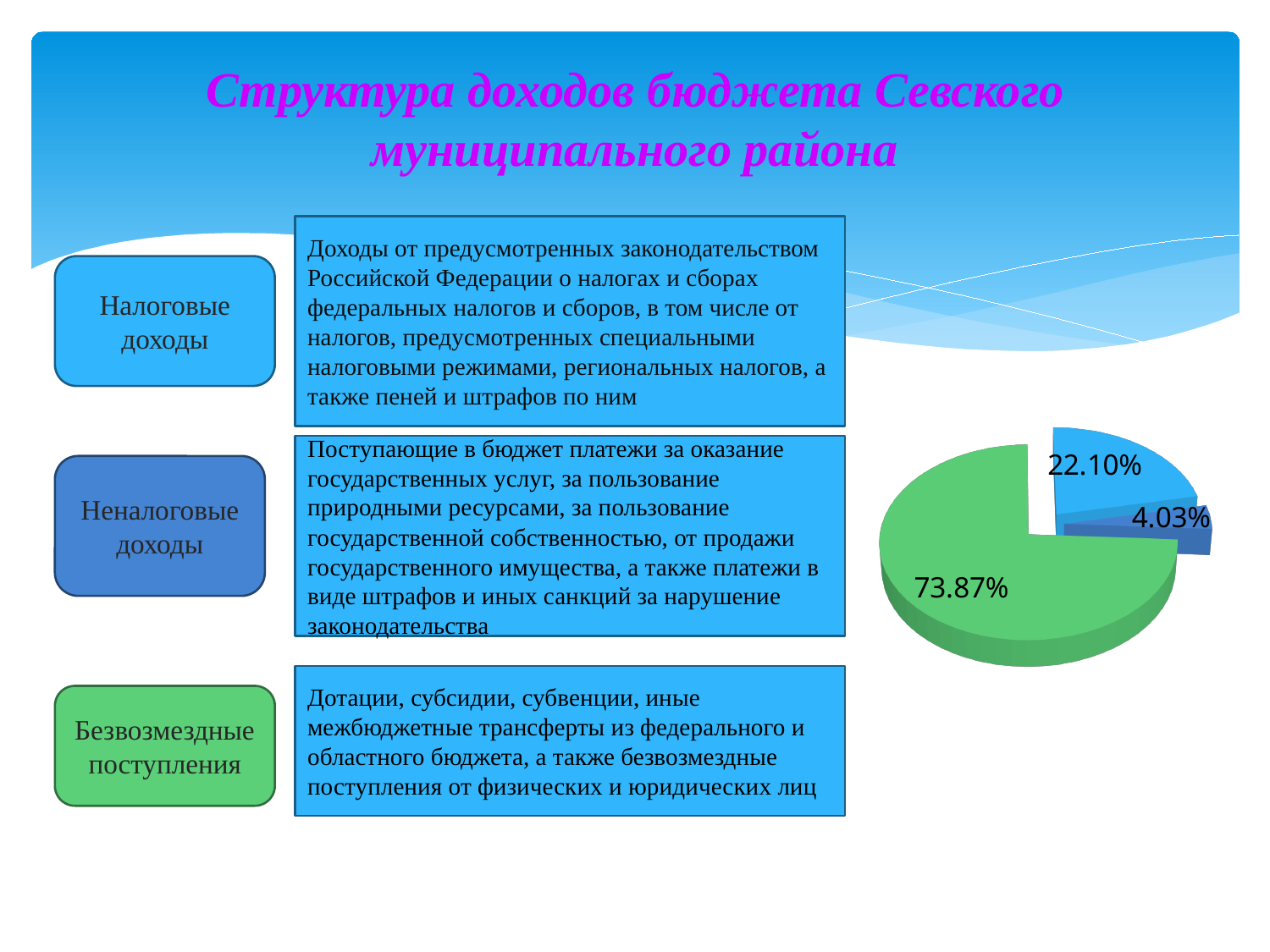
What is the title of the slide containing the pie chart? Структура доходов бюджета Севского муниципального района Is the largest slice of the pie chart greater or less than 50%? greater What kind of chart is shown on the slide? pie chart What is the value of the smallest slice of the pie chart? 4.03% Which slice is larger, the green one or the light blue one? the green one What percentage is shown on the dark blue slice of the pie chart? 4.03% What percentage is shown on the green slice of the pie chart? 73.87% What is the difference between the 22.10% slice and the 4.03% slice? 18.07% What is the value of the largest slice of the pie chart? 73.87% How many slices does the pie chart have? 3 What percentage is shown on the light blue slice of the pie chart? 22.10% What is the difference between the largest slice (73.87%) and the 22.10% slice? 51.77%